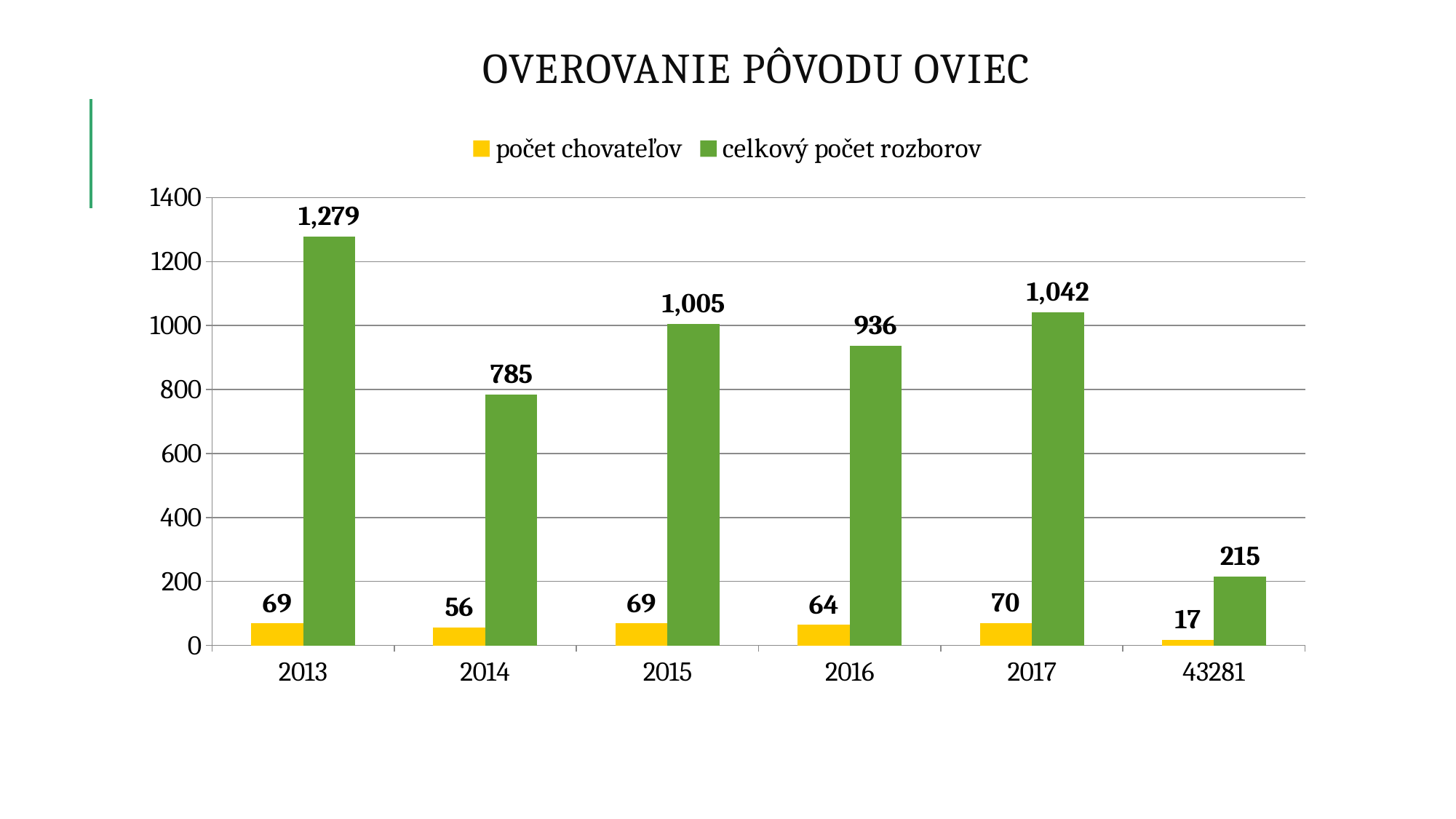
What is the value of 'počet chovateľov' for 2014? 56 How many series does the legend list? 2 How many categories are shown on the x axis? 6 What is the value of 'celkový počet rozborov' for 2013? 1,279 What kind of chart is shown on the slide? bar chart What is the difference between 'celkový počet rozborov' in 2017 and in 2015? 37 What is the value of 'celkový počet rozborov' for 2016? 936 Is the value of 'celkový počet rozborov' for 2015 greater or less than 800? greater Which category has the lowest value for 'počet chovateľov'? 43281 Which category has the highest value for 'celkový počet rozborov'? 2013 What is the value of 'počet chovateľov' for the category labelled 43281? 17 Which is larger: 'celkový počet rozborov' in 2014 or in 2016? 2016